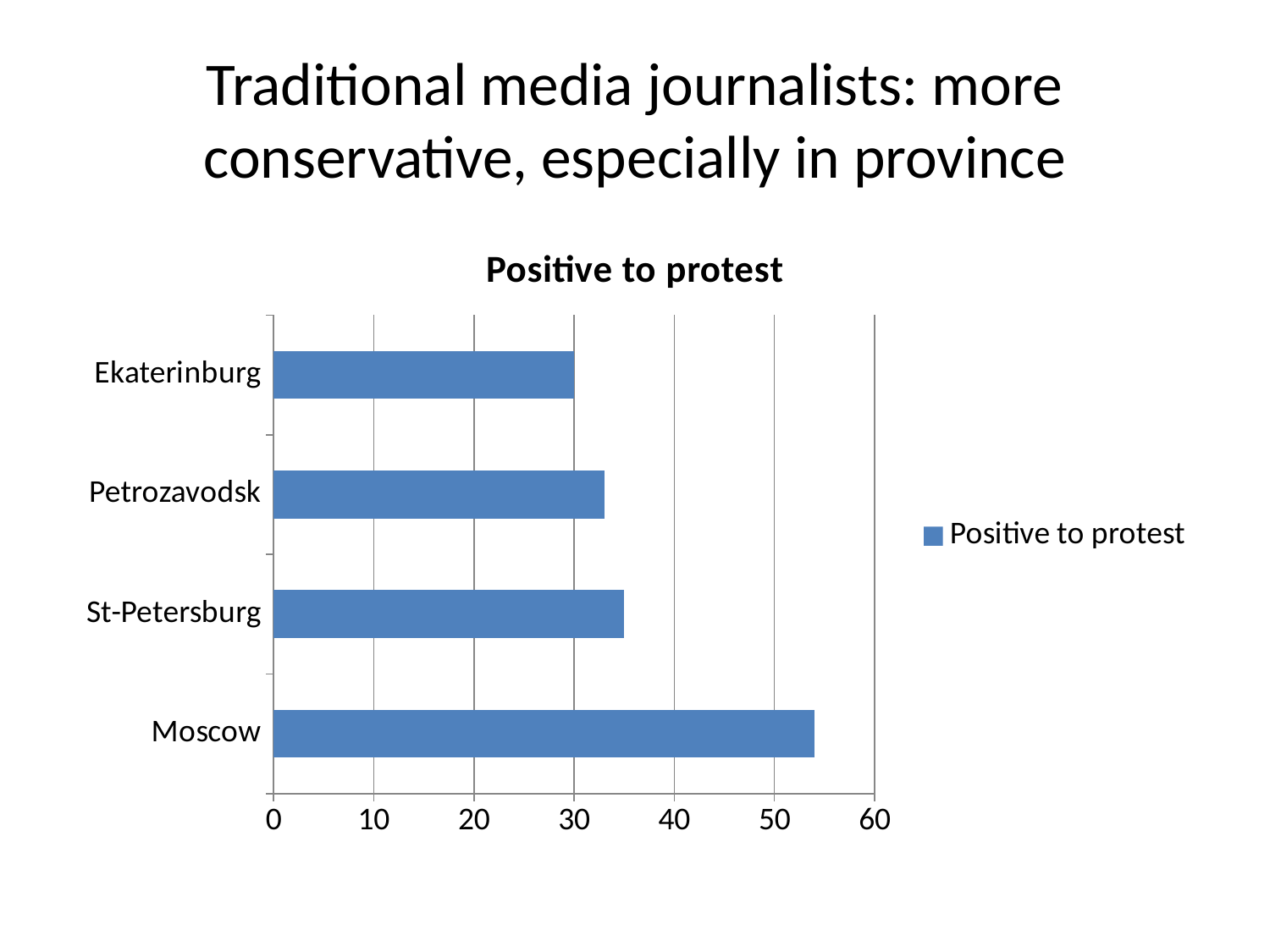
Which city has the highest value for Positive to protest? Moscow Which is larger, the value for Moscow or the value for St-Petersburg? Moscow What is the value for Ekaterinburg? 30 Is the value for Petrozavodsk greater or less than 30? greater What is the legend entry shown on the chart? Positive to protest How many series does the legend list? 1 What kind of chart is shown on the slide? bar chart Is the value for St-Petersburg greater or less than 40? less Which city has the lowest value for Positive to protest? Ekaterinburg How many cities are shown in the chart? 4 Is the value for Moscow greater or less than 50? greater What is the title of the chart? Positive to protest